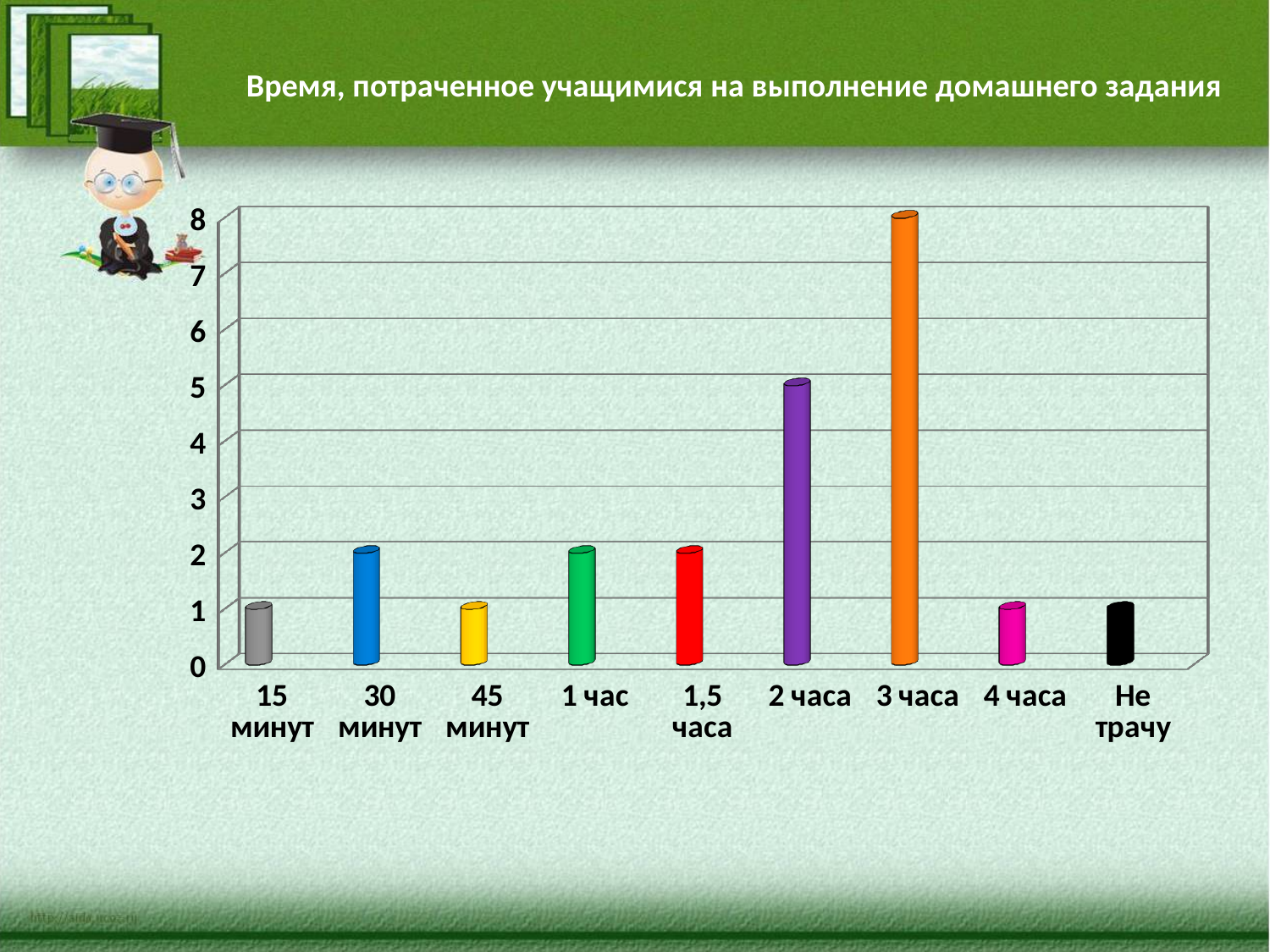
What is the difference between the values for 3 часа and 2 часа? 3 What is the value for Не трачу? 1 What kind of chart is shown on the slide? bar chart What is the difference between the values for 2 часа and 1 час? 3 How many categories are shown on the x axis? 9 Which category has the highest value? 3 часа What is the value for 30 минут? 2 What is the title of the chart? Время, потраченное учащимися на выполнение домашнего задания What is the value for 2 часа? 5 Is the value for 3 часа greater or less than 6? greater Which is larger, the value for 30 минут or the value for 45 минут? 30 минут What is the value for 3 часа? 8